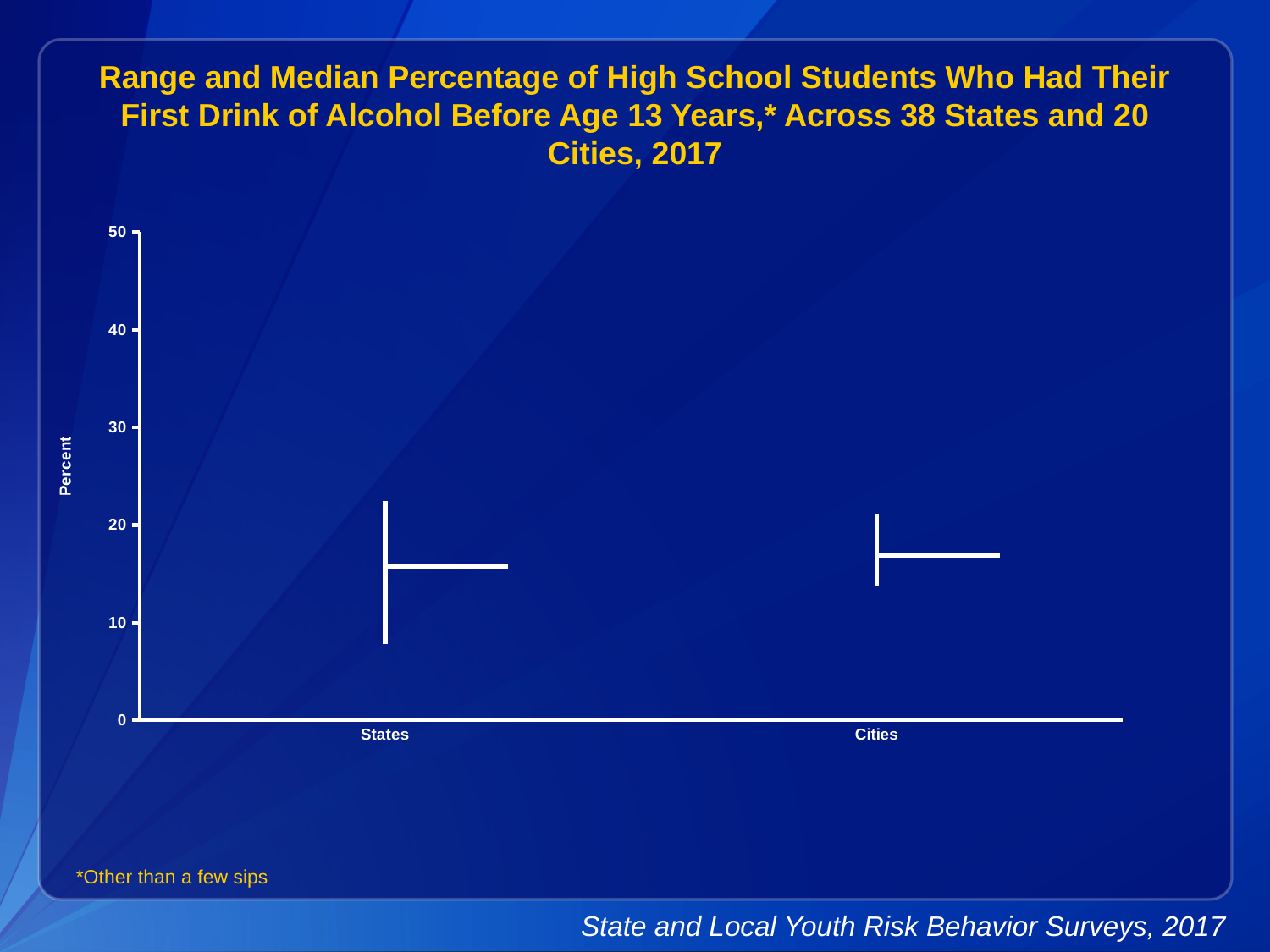
Is the bottom of the range for States greater or less than 10? less What is the label on the y axis of the chart? Percent Is the median value for States greater or less than 20? less Which category shows the wider range of values, States or Cities? States Is the top of the range for States greater or less than 20? greater What are the two categories shown on the x axis? States and Cities How many categories are shown on the x axis of the chart? 2 Which category has the lower minimum value in its range, States or Cities? States What kind of chart is shown on the slide? A range (high-low) chart with median markers